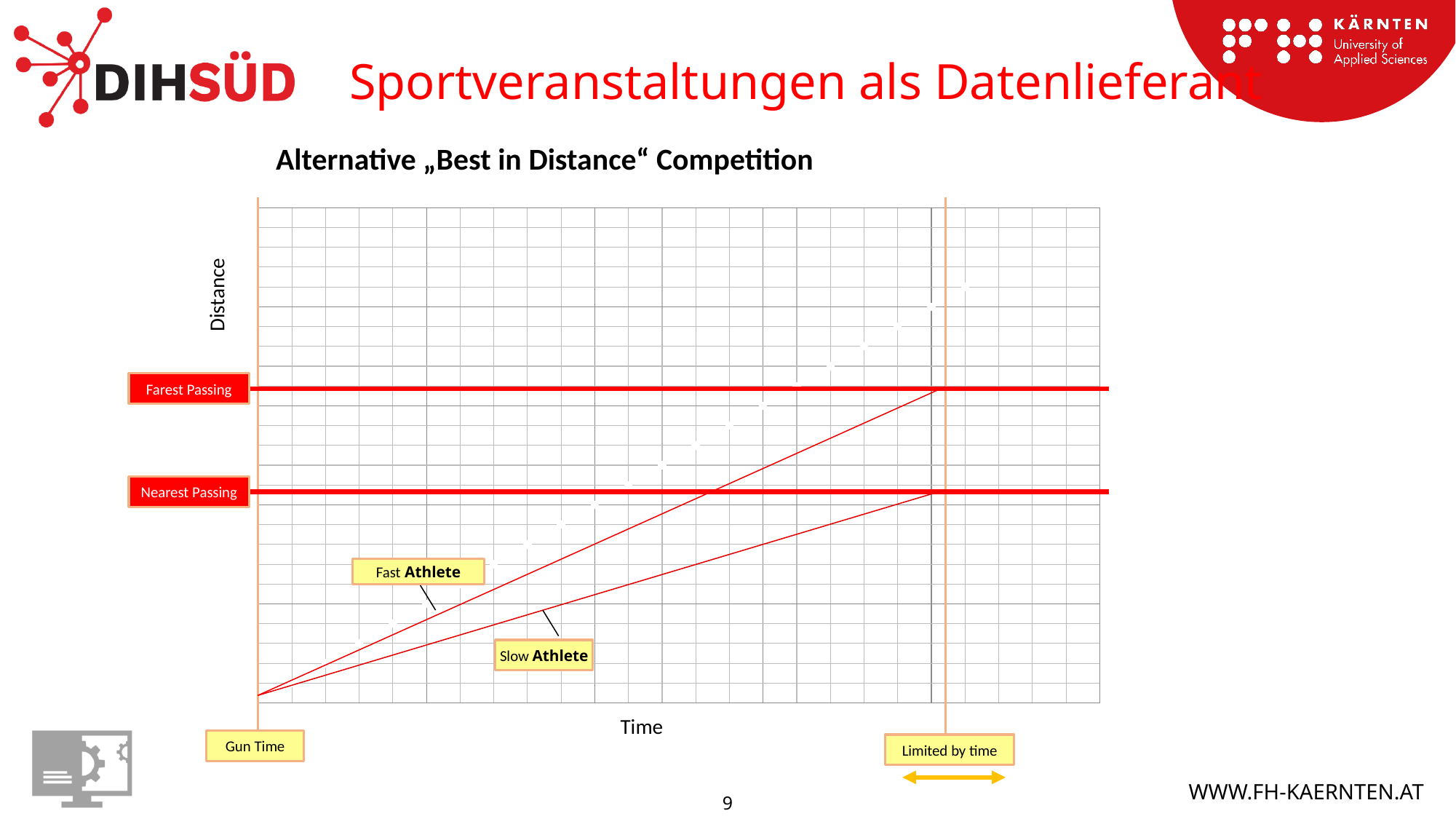
What label marks the start point of the athlete lines on the time axis? Gun Time Do the athlete lines rise or fall as time increases? rise What is the label of the horizontal axis of the chart? Time What is the label of the vertical axis of the chart? Distance Which athlete line reaches the lower distance at the time limit? Slow Athlete What kind of chart is shown on the slide? line chart What is the title of the chart? Alternative „Best in Distance“ Competition How many athlete lines are plotted on the chart? 2 Which horizontal passing line is at the greater distance, Farest Passing or Nearest Passing? Farest Passing Which athlete line reaches the greater distance at the time limit, Fast Athlete or Slow Athlete? Fast Athlete Which athlete line reaches the Nearest Passing line at the time limit? Slow Athlete Which athlete line reaches the Farest Passing line at the time limit? Fast Athlete